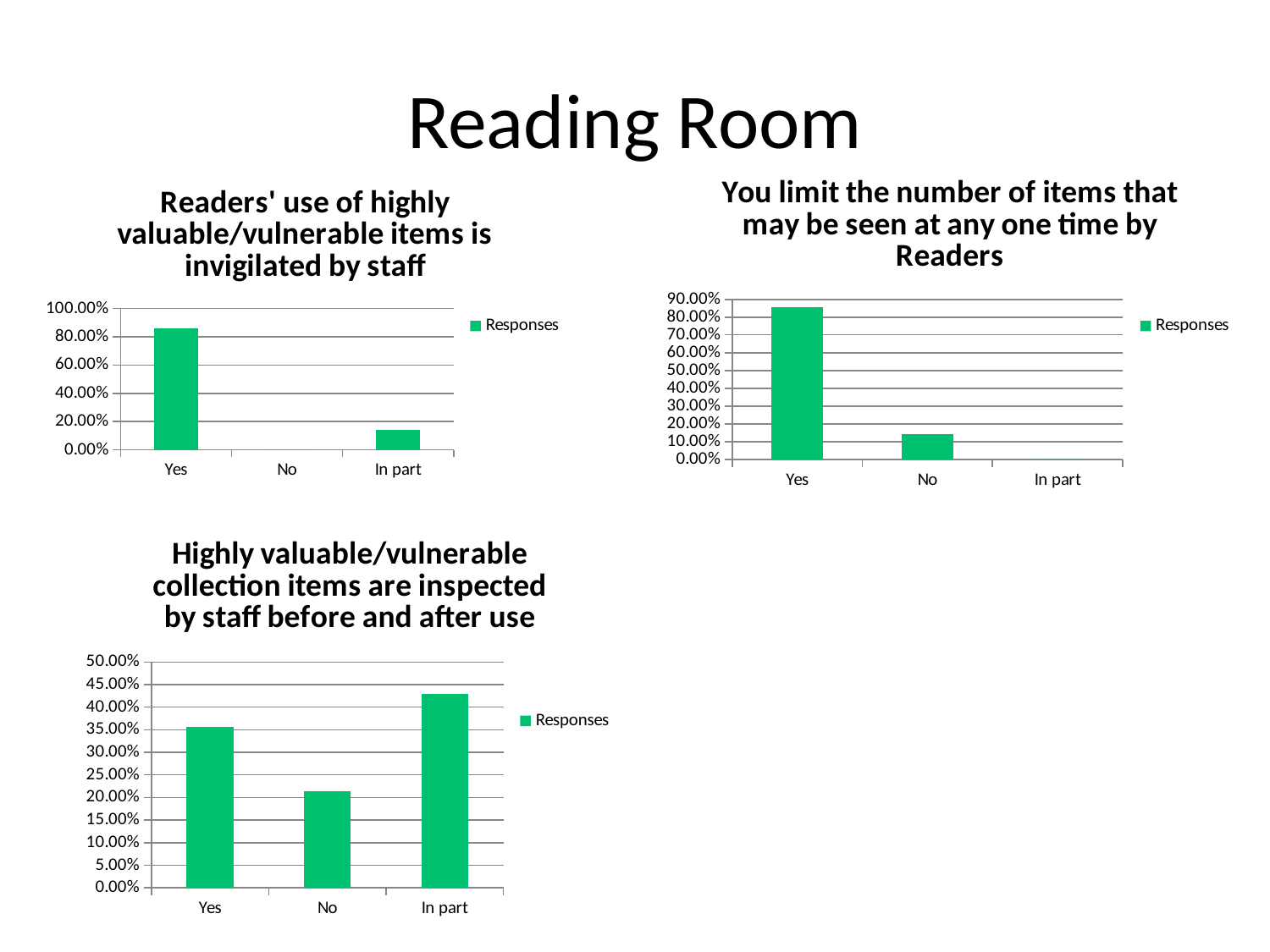
In the chart titled "Readers' use of highly valuable/vulnerable items is invigilated by staff", which category has the highest value? Yes In the chart titled "You limit the number of items that may be seen at any one time by Readers", which category has the lowest value? In part In the chart titled "Readers' use of highly valuable/vulnerable items is invigilated by staff", is the value for Yes greater or less than 80.00%? greater In the chart titled "Highly valuable/vulnerable collection items are inspected by staff before and after use", is the value for Yes greater or less than 30.00%? greater In the chart titled "Highly valuable/vulnerable collection items are inspected by staff before and after use", how many categories are shown on the x axis? 3 In the chart titled "Readers' use of highly valuable/vulnerable items is invigilated by staff", is the value for In part greater or less than 20.00%? less In the chart titled "Highly valuable/vulnerable collection items are inspected by staff before and after use", which category has the highest value? In part In the chart titled "Highly valuable/vulnerable collection items are inspected by staff before and after use", which category has the lowest value? No In the chart titled "Readers' use of highly valuable/vulnerable items is invigilated by staff", how many series does the legend list? 1 In the chart titled "You limit the number of items that may be seen at any one time by Readers", which is larger, the value for Yes or the value for No? Yes What kind of chart is the chart titled "You limit the number of items that may be seen at any one time by Readers"? Bar chart